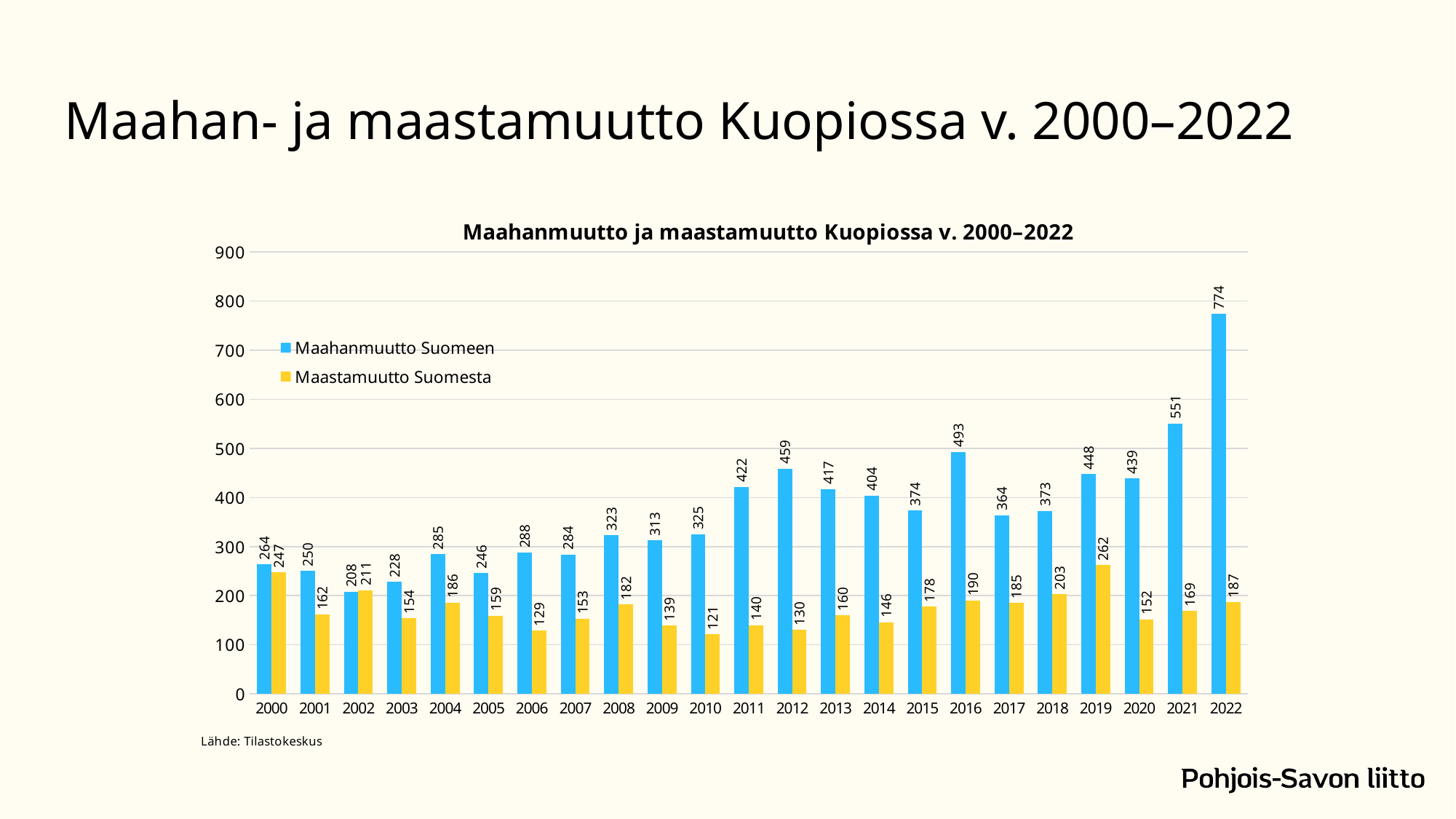
How many years are shown on the x axis? 23 What is the difference between Maahanmuutto Suomeen and Maastamuutto Suomesta in 2021? 382 What is the value of Maastamuutto Suomesta in 2019? 262 What is the value of Maahanmuutto Suomeen in 2010? 325 How many series does the legend list? 2 What is the value of Maahanmuutto Suomeen in 2022? 774 Which is larger in 2002, Maahanmuutto Suomeen or Maastamuutto Suomesta? Maastamuutto Suomesta Is the value for Maahanmuutto Suomeen in 2016 greater or less than 400? greater Which year has the lowest value for Maastamuutto Suomesta? 2010 What is the title of the chart? Maahanmuutto ja maastamuutto Kuopiossa v. 2000–2022 Which year has the highest value for Maahanmuutto Suomeen? 2022 What kind of chart is shown on the slide? Bar chart